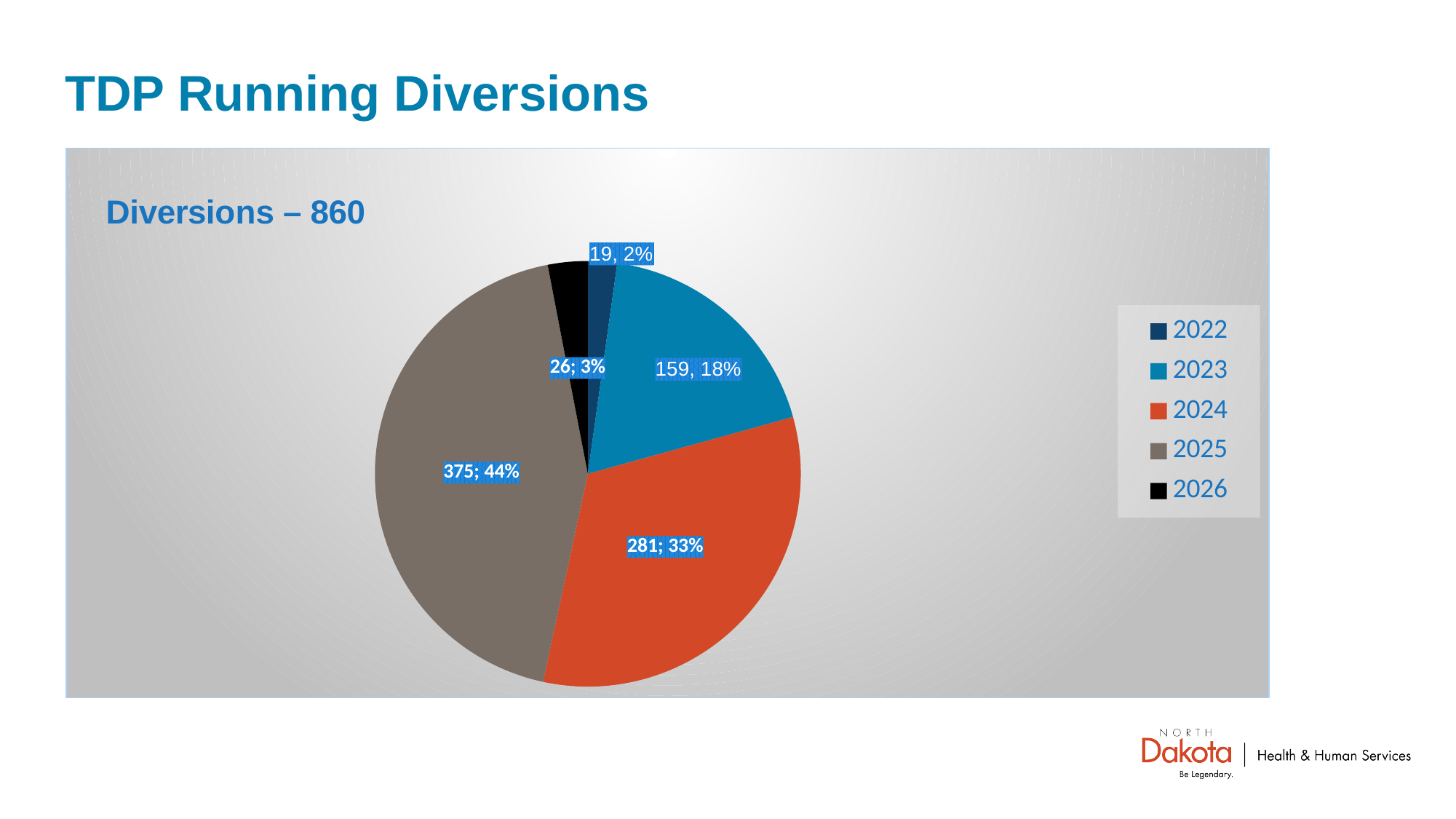
How many entries does the legend list? 5 What share of the pie does 2026 represent? 3% What is the title of the chart? Diversions – 860 What is the value for 2023? 159 What is the value for 2024? 281 What is the difference between the values for 2025 and 2024? 94 What is the value for 2025? 375 What kind of chart is shown on the slide? Pie chart How many slices does the pie chart have? 5 Which year has the largest slice? 2025 What is the value for 2022? 19 Which year has the smallest slice? 2022